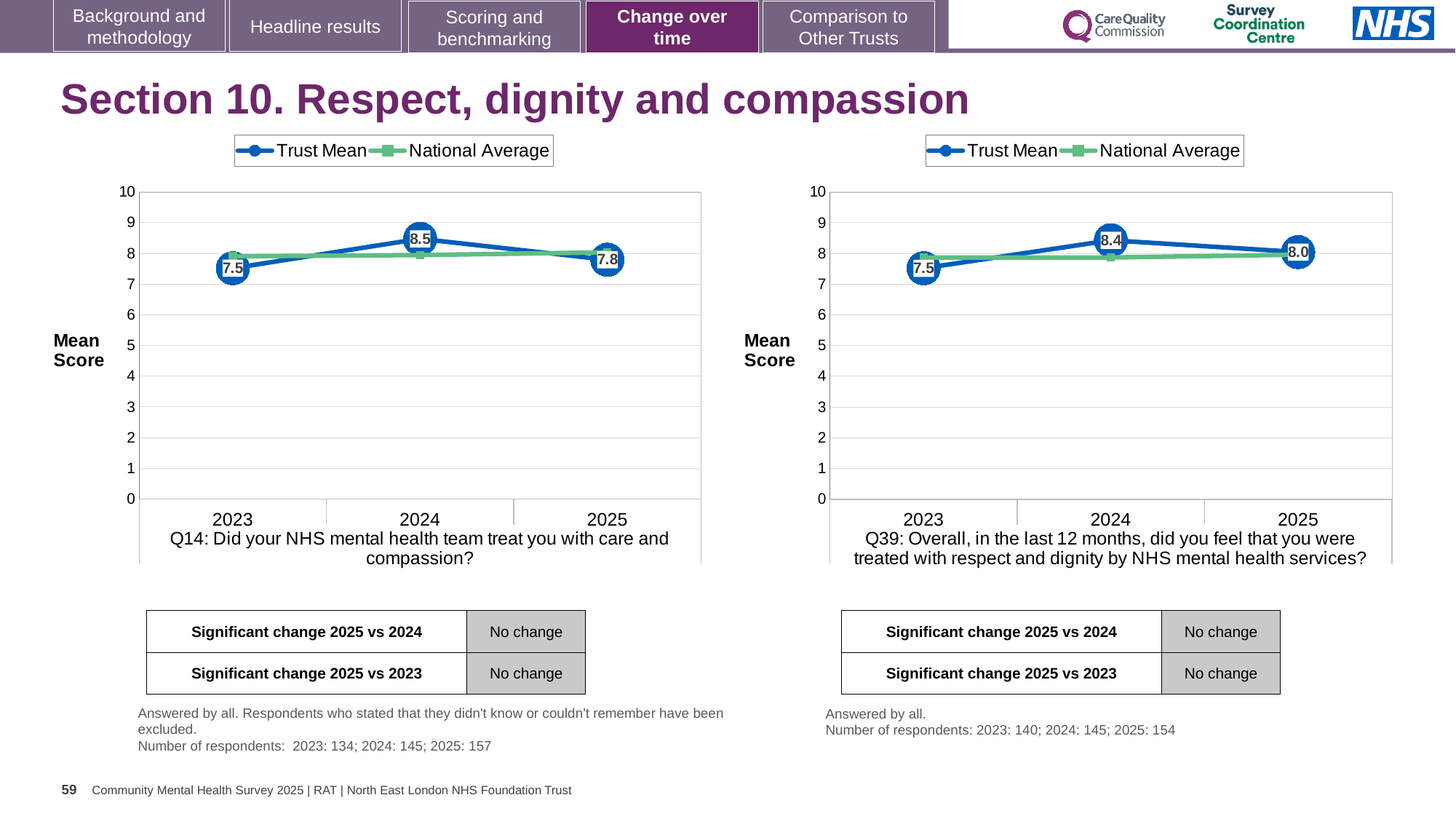
On the Q14 chart (left), what is the Trust Mean for 2024? 8.5 What kind of chart is the Q14 chart (left)? Line chart On the Q39 chart (right), what is the Trust Mean for 2025? 8.0 On the Q39 chart (right), what is the Trust Mean for 2023? 7.5 How many series does the legend of the Q39 chart (right) list? 2 On the Q14 chart (left), what is the difference between the Trust Mean for 2024 and 2025? 0.7 On the Q14 chart (left), which year has the highest Trust Mean? 2024 On the Q39 chart (right), what is the difference between the Trust Mean for 2024 and 2023? 0.9 On the Q39 chart (right), which year has the lowest Trust Mean? 2023 On the Q39 chart (right), is the Trust Mean for 2025 greater or less than the Trust Mean for 2023? greater On the Q14 chart (left), is the National Average for 2024 greater or less than 7? greater On the Q14 chart (left), what is the Trust Mean for 2025? 7.8